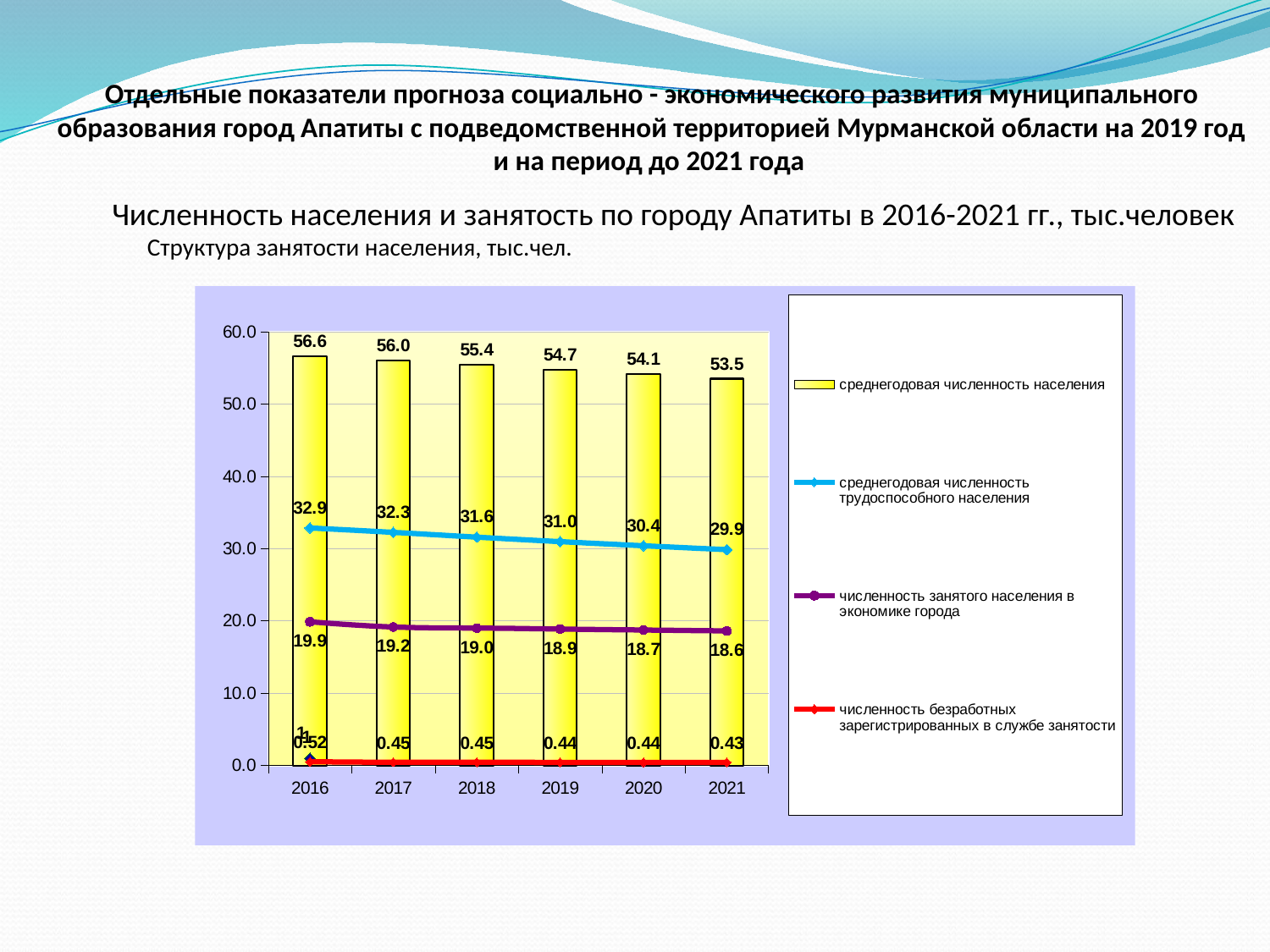
What is the difference between среднегодовая численность населения in 2016 and in 2021? 3.1 In which year is среднегодовая численность трудоспособного населения the highest? 2016 What is the value of численность безработных зарегистрированных в службе занятости in 2018? 0.45 What is the average annual population (среднегодовая численность населения) shown for 2016? 56.6 Which is larger: среднегодовая численность трудоспособного населения in 2017 or численность занятого населения в экономике города in 2017? среднегодовая численность трудоспособного населения How many years are shown on the x axis of the chart? 6 Does среднегодовая численность населения rise or fall from 2016 to 2021? fall How many series does the chart legend list? 4 What is the value of численность занятого населения в экономике города in 2021? 18.6 What is the value of среднегодовая численность трудоспособного населения in 2019? 31.0 Which series in the chart is drawn as yellow bars? среднегодовая численность населения In which year is среднегодовая численность населения the lowest? 2021